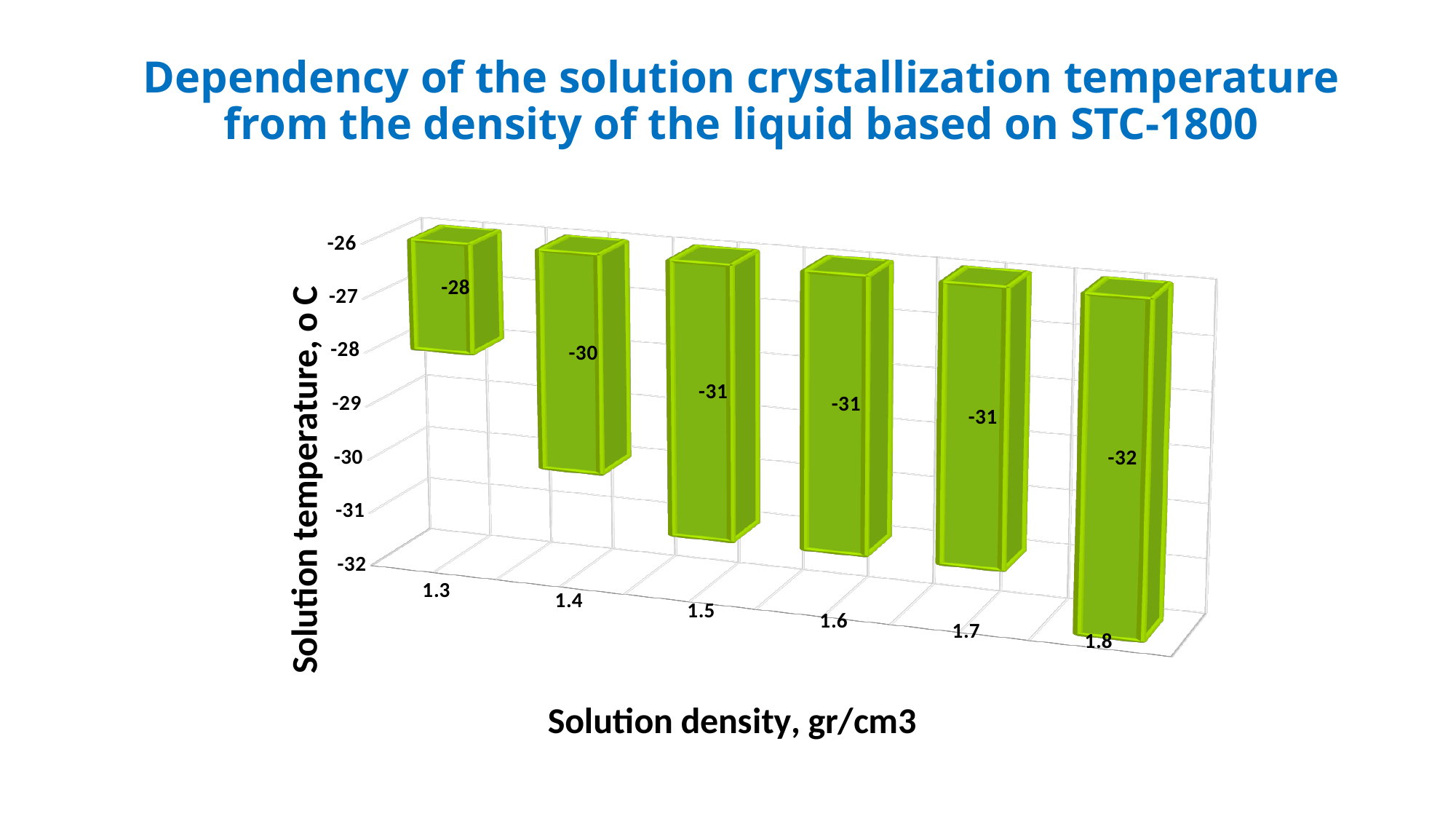
Which solution density has the highest (warmest) solution temperature? 1.3 What kind of chart is shown on the slide? Bar chart What is the solution temperature at a solution density of 1.6 gr/cm3? -31 Which is higher, the solution temperature at density 1.4 or at density 1.8? 1.4 What is the solution temperature at a solution density of 1.4 gr/cm3? -30 What is the difference between the solution temperature at density 1.3 and at density 1.8? 4 Does the solution temperature rise or fall as the solution density increases from 1.3 to 1.8? Fall What is the solution temperature at a solution density of 1.8 gr/cm3? -32 Which solution density has the lowest (coldest) solution temperature? 1.8 How many solution density values are plotted on the chart? 6 What is the label of the horizontal axis of the chart? Solution density, gr/cm3 What is the solution temperature at a solution density of 1.3 gr/cm3? -28